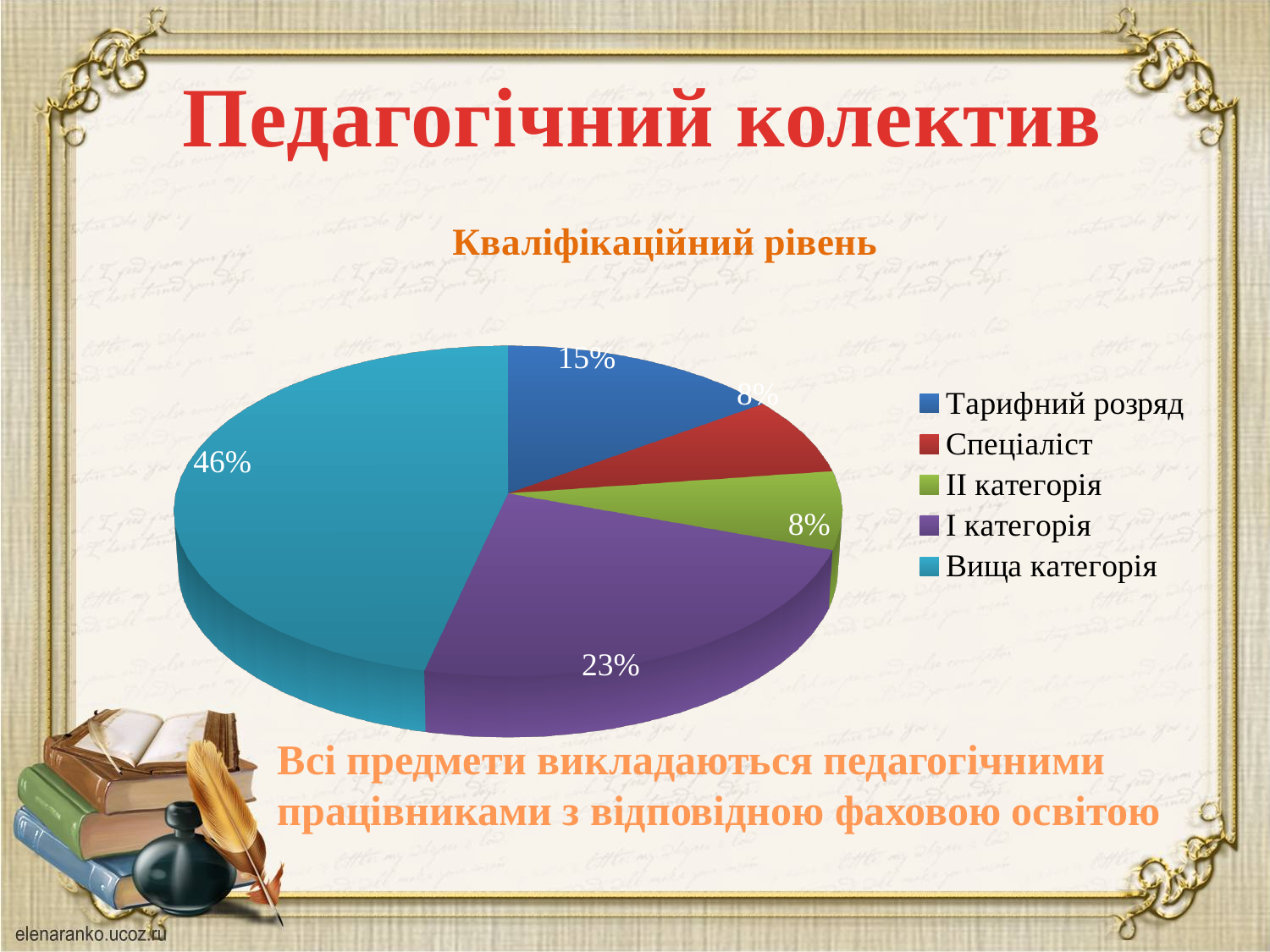
Which legend entry is shown in purple? І категорія What is the difference between the shares of "Тарифний розряд" and "ІІ категорія"? 7% What is the title of the chart? Кваліфікаційний рівень Which is larger: the share for "І категорія" or the share for "Тарифний розряд"? І категорія Which category has the largest share of the pie? Вища категорія What share of the pie does "Тарифний розряд" have? 15% How many categories does the legend of the chart list? 5 What share of the pie does "Вища категорія" have? 46% What kind of chart is shown on the slide? pie chart What share of the pie does "І категорія" have? 23% What is the difference between the shares of "Вища категорія" and "І категорія"? 23%